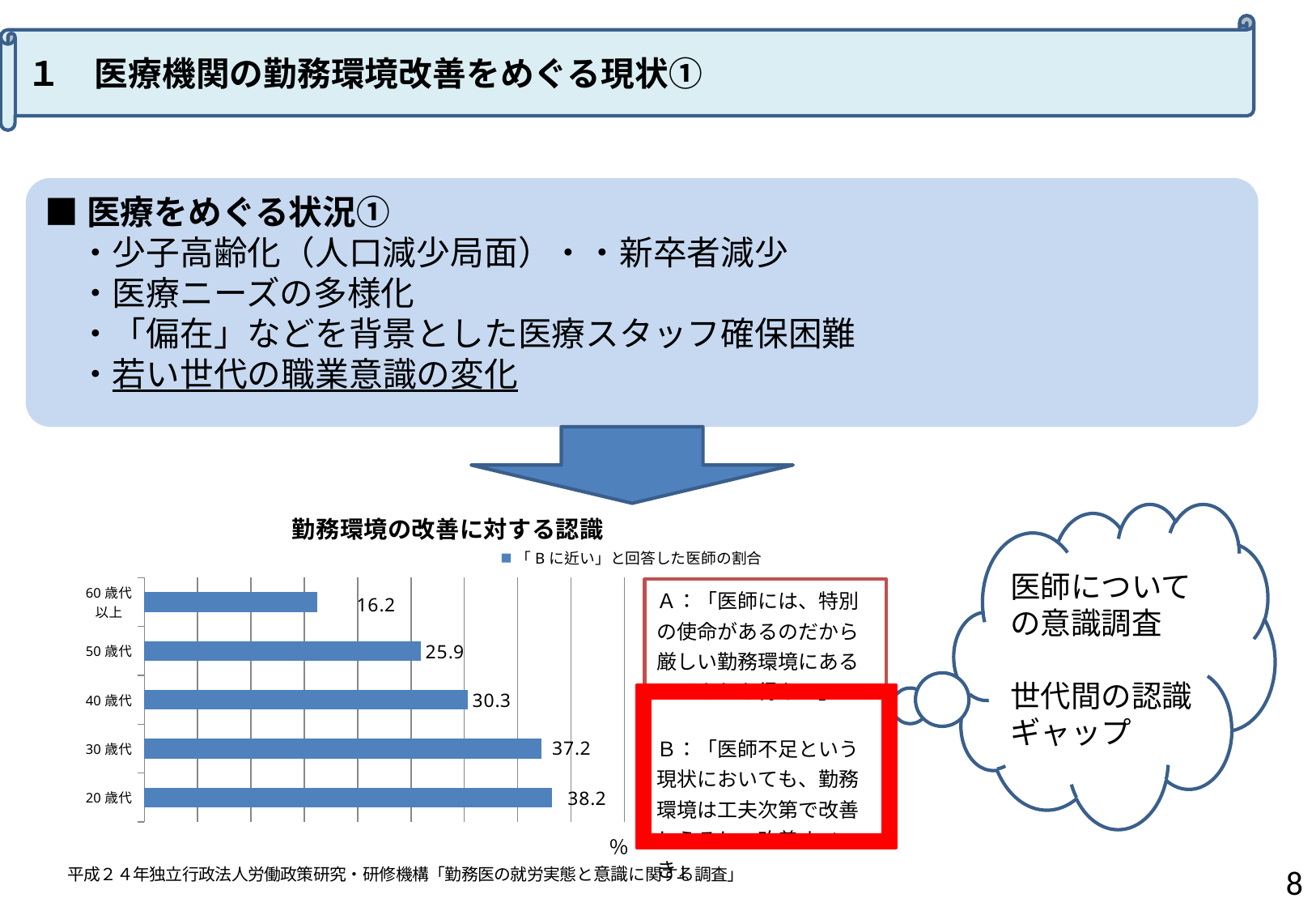
What is the value for 60歳代以上 in the chart? 16.2 Which age group has the highest value in the chart? 20歳代 Do the values increase or decrease as the age group gets older, from 20歳代 to 60歳代以上? decrease What is the value for 20歳代 in the chart? 38.2 Which age group has the lowest value in the chart? 60歳代以上 What type of chart is shown under the title 勤務環境の改善に対する認識? bar chart What is the value for 40歳代 in the chart? 30.3 What is the difference between the values for 20歳代 and 60歳代以上? 22.0 How many age-group categories are plotted in the chart? 5 What is the difference between the values for 30歳代 and 50歳代? 11.3 Which is larger, the value for 40歳代 or the value for 50歳代? 40歳代 What is the legend entry of the chart? 「Bに近い」と回答した医師の割合